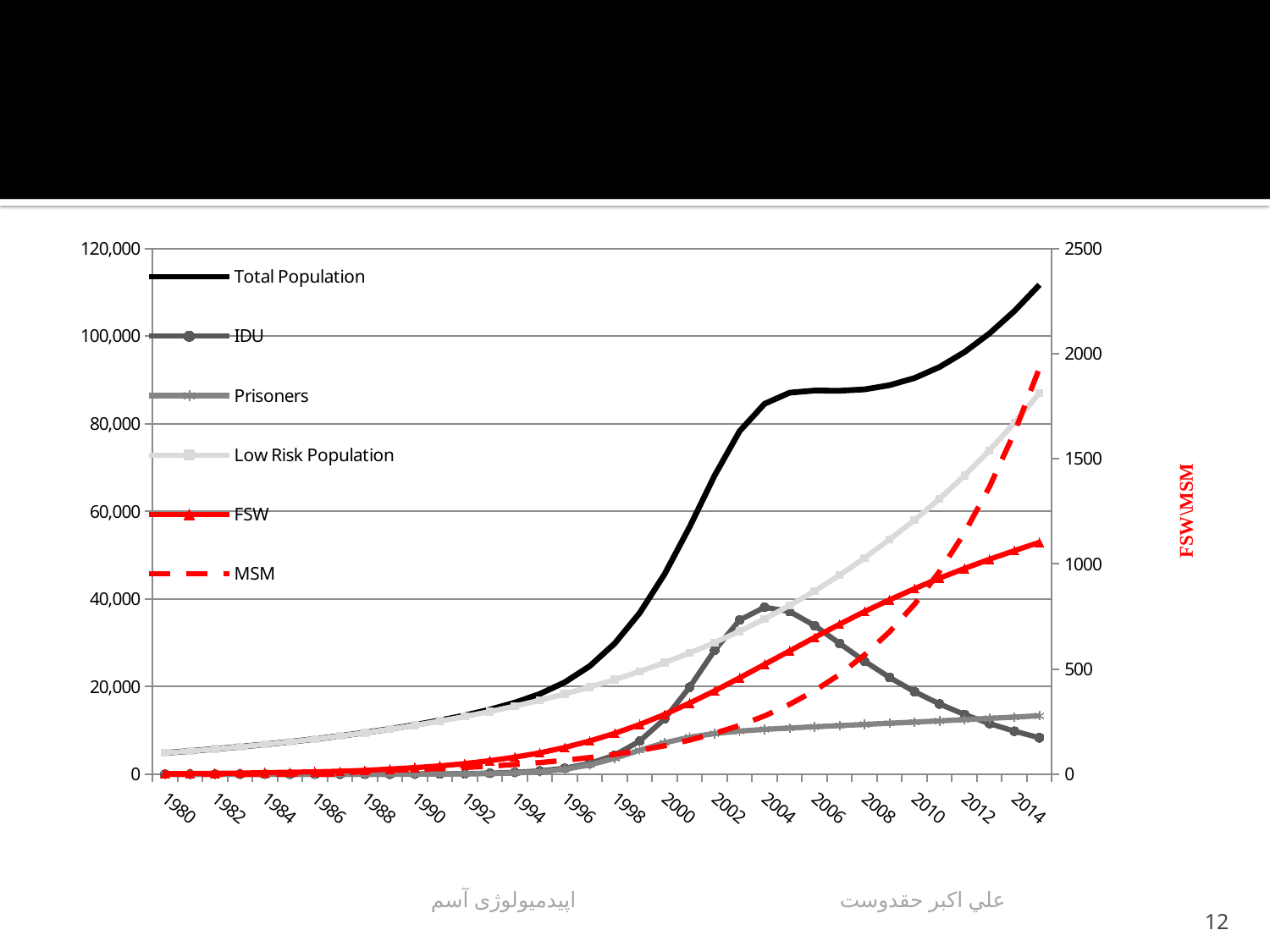
Which series is drawn with a dashed line? MSM Is the value for IDU in 2004 greater or less than 20,000? greater Is the value for Prisoners in 2014 greater or less than 20,000? less Is the value for MSM in 2014 greater or less than 1500 on the right axis? greater What is the label of the right-hand vertical axis? FSW\MSM How many series does the legend list? 6 Which series reaches the highest value on the left axis in 2014? Total Population In 2014, which is higher: MSM or FSW? MSM Does the IDU series rise or fall between 2004 and 2014? fall What kind of chart is shown on the slide? line chart